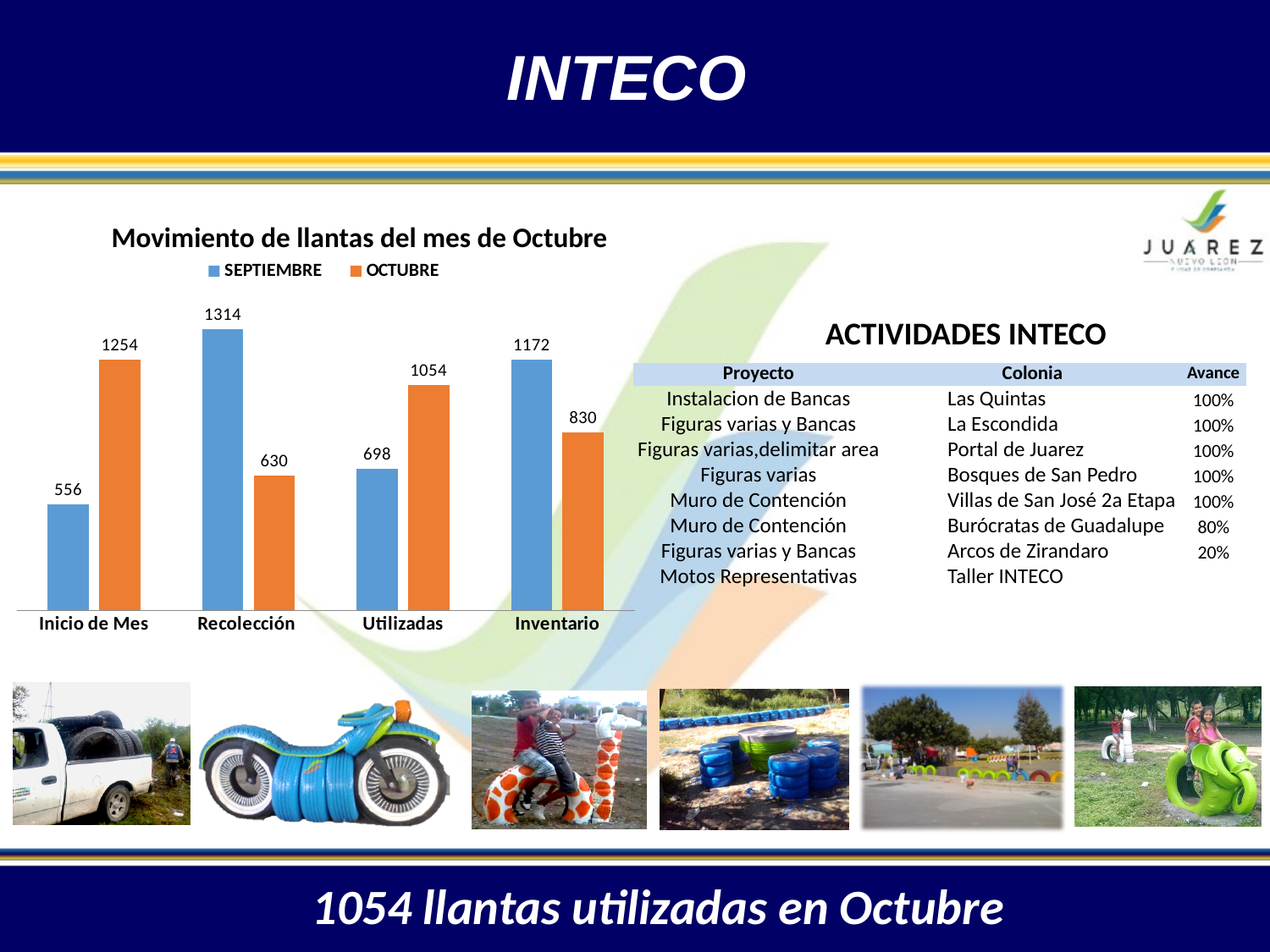
Which category has the lowest OCTUBRE value? Recolección What is the OCTUBRE value for Utilizadas? 1054 Which colour represents the OCTUBRE series in the chart? Orange Which is larger for Inventario, the SEPTIEMBRE value or the OCTUBRE value? SEPTIEMBRE What is the SEPTIEMBRE value for Inicio de Mes? 556 Which category has the highest SEPTIEMBRE value? Recolección What is the difference between the SEPTIEMBRE and OCTUBRE values for Recolección? 684 How many categories are shown on the x axis of the chart? 4 What kind of chart is shown on the slide? Bar chart How many series does the chart legend list? 2 What is the SEPTIEMBRE value for Inventario? 1172 What is the title of the chart? Movimiento de llantas del mes de Octubre